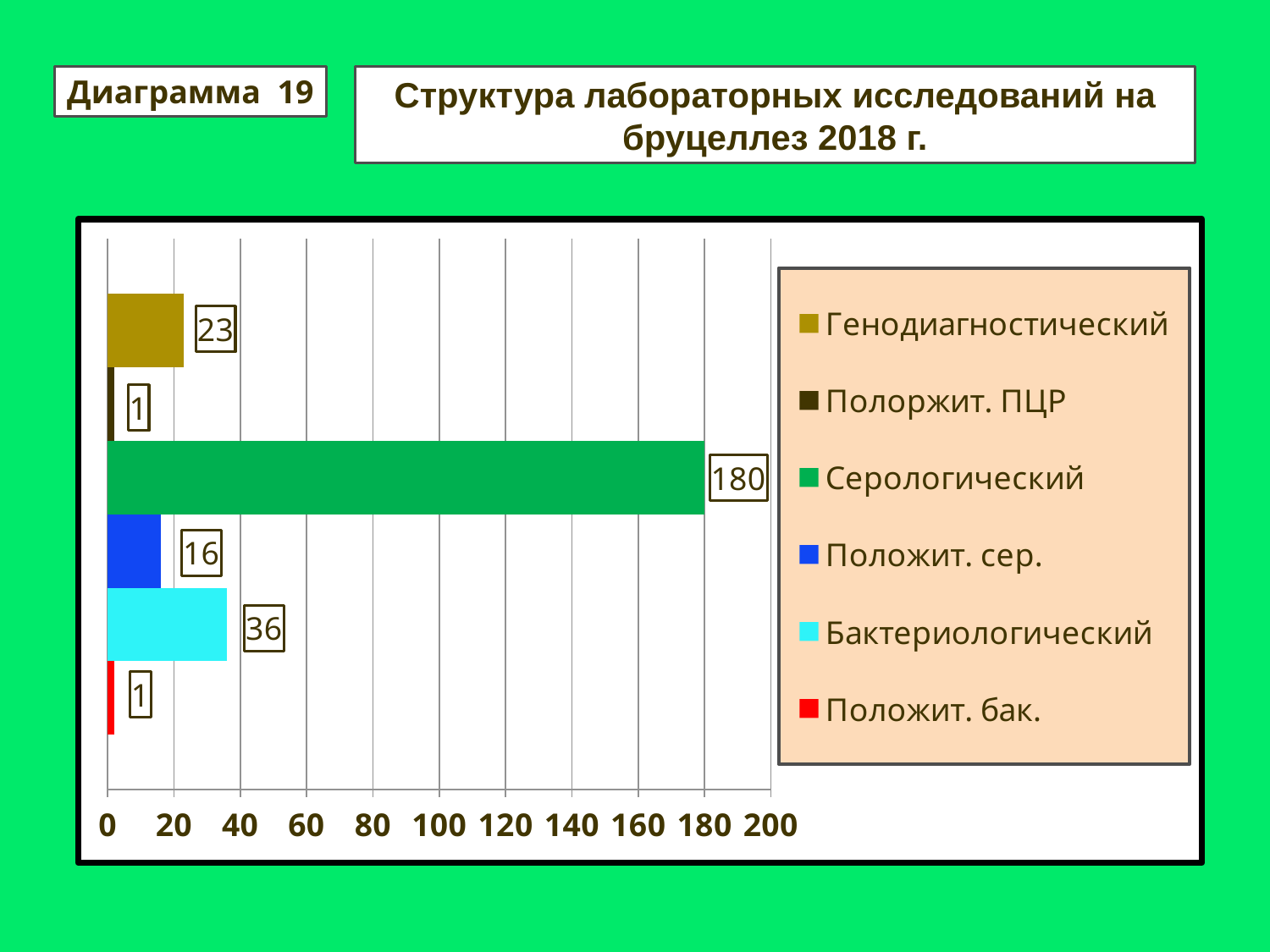
Which series has the highest value? Серологический What is the value for Серологический? 180 What is the difference between the values for Серологический and Бактериологический? 144 What is the value for Генодиагностический? 23 What is the difference between the values for Генодиагностический and Положит. сер.? 7 How many series does the legend list? 6 What is the title of the chart? Структура лабораторных исследований на бруцеллез 2018 г. What kind of chart is shown on the slide? bar chart What is the value for Положит. сер.? 16 Which is larger, the value for Бактериологический or the value for Генодиагностический? Бактериологический Is the value for Серологический greater or less than 160? greater What is the value for Бактериологический? 36